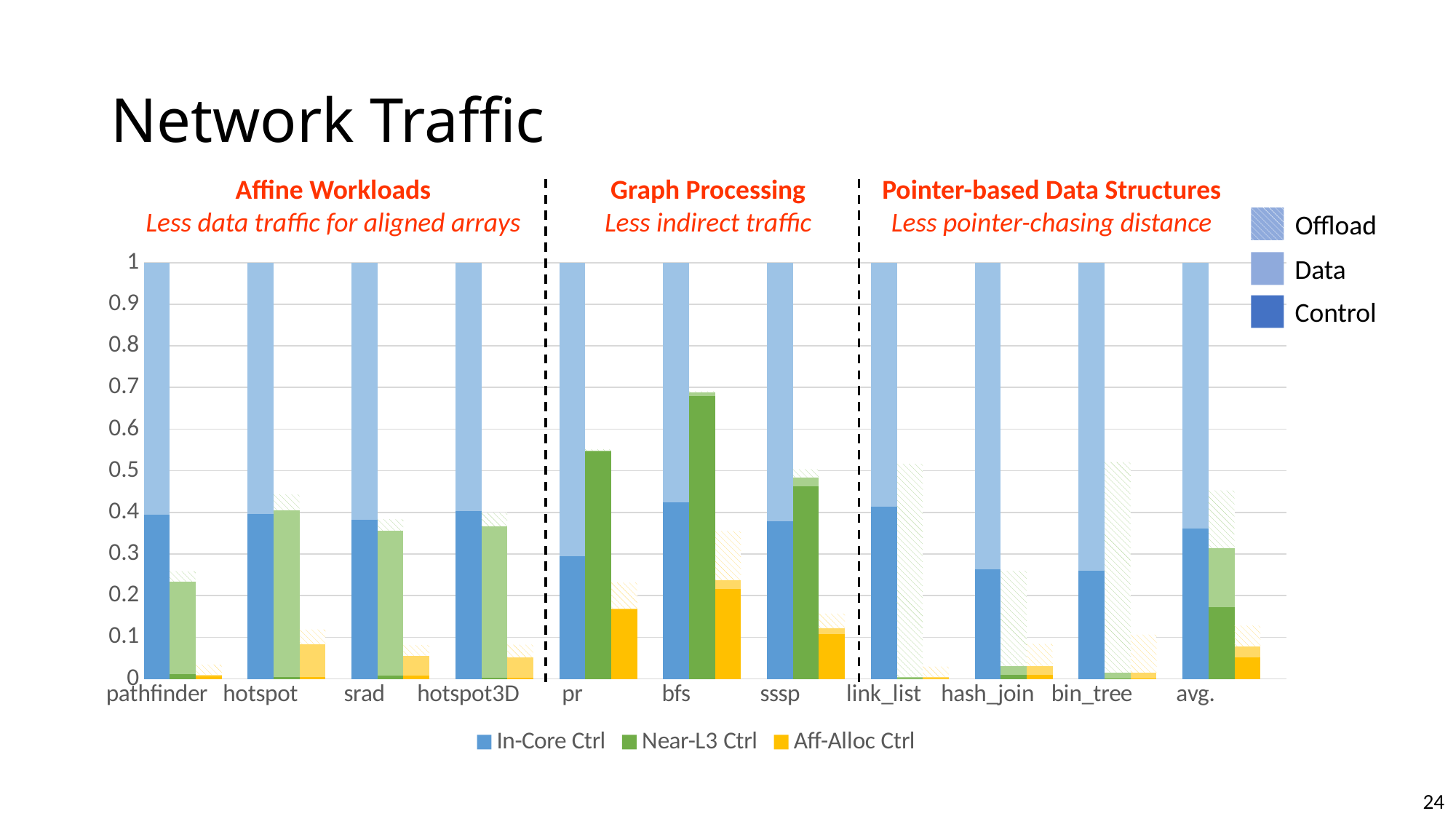
How many series does the legend at the bottom of the chart list? 3 What is the total height of the In-Core Ctrl bar for pathfinder? 1 What kind of chart is shown on the slide? bar chart Is the Near-L3 Ctrl value for pathfinder greater or less than 0.3? less Which category has the tallest Aff-Alloc Ctrl bar? bfs Which is larger, the Near-L3 Ctrl bar for pr or for sssp? pr What is the title of the slide containing the chart? Network Traffic How many categories are shown along the x axis of the chart? 11 Is the Near-L3 Ctrl value for bfs greater or less than 0.6? greater Which category has the tallest Near-L3 Ctrl bar? bfs Which is larger, the Near-L3 Ctrl bar for hotspot or for pathfinder? hotspot Is the Near-L3 Ctrl value for pr greater or less than 0.5? greater